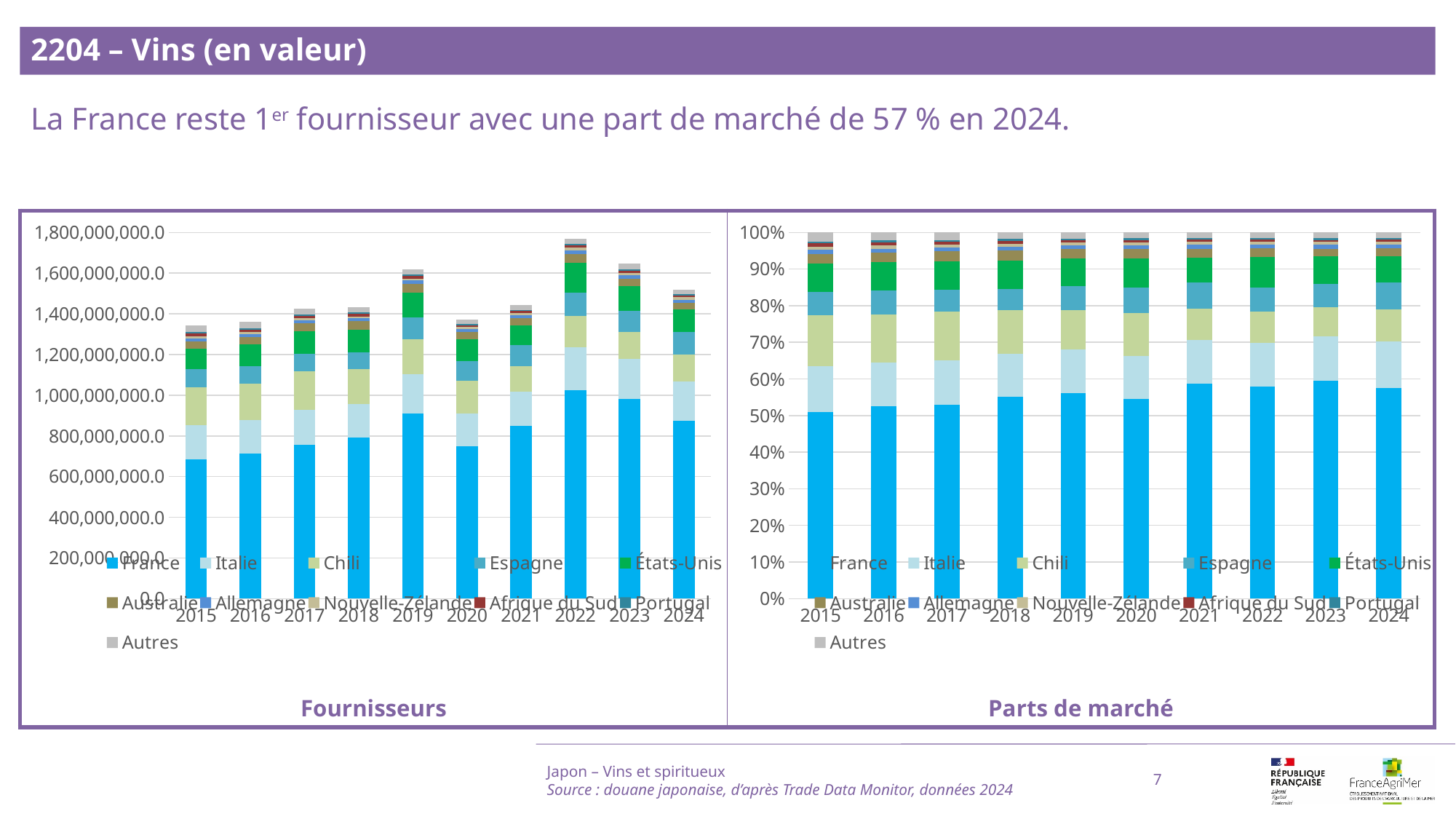
How many years are shown on the x axis of the 'Parts de marché' chart? 10 In the 'Parts de marché' chart, is the share for France in 2015 greater or less than 60%? less In the 'Parts de marché' chart, is the share for France in 2024 greater or less than 50%? greater In the 'Fournisseurs' chart, is the total stacked bar for 2022 greater or less than 1,600,000,000.0? greater How many series does the legend of the 'Fournisseurs' chart list? 11 Which series is listed first in the legend of the 'Fournisseurs' chart? France What is the title of the chart on the right of the slide? Parts de marché In the 'Fournisseurs' chart, do the total stacked bars rise or fall from 2015 to 2019? rise What kind of chart is the 'Fournisseurs' chart on the left? stacked bar chart In the 'Parts de marché' chart, which is larger: the France share in 2015 or in 2023? 2023 In the 'Fournisseurs' chart, which year has the highest total stacked bar? 2022